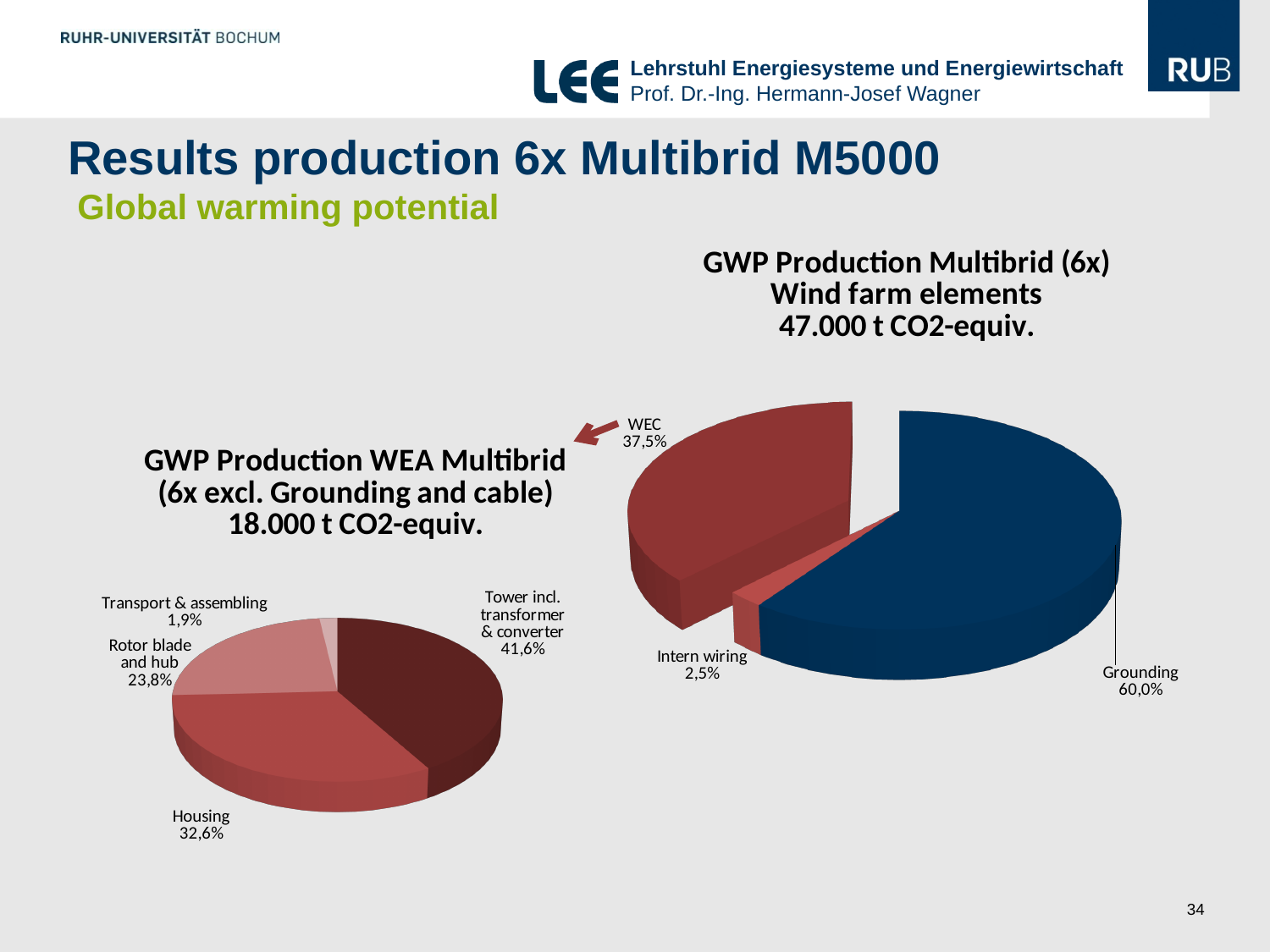
In the 'GWP Production Multibrid (6x) Wind farm elements' chart, what share does WEC have? 37,5% In the 'GWP Production Multibrid (6x) Wind farm elements' chart, how many slices are there? 3 In the 'GWP Production Multibrid (6x) Wind farm elements' chart, what share does Grounding have? 60,0% In the 'GWP Production WEA Multibrid (6x excl. Grounding and cable)' chart, what share does Rotor blade and hub have? 23,8% In the 'GWP Production WEA Multibrid (6x excl. Grounding and cable)' chart, what share does Housing have? 32,6% In the 'GWP Production WEA Multibrid (6x excl. Grounding and cable)' chart, which slice is the smallest? Transport & assembling In the 'GWP Production WEA Multibrid (6x excl. Grounding and cable)' chart, which slice is the largest? Tower incl. transformer & converter In the 'GWP Production WEA Multibrid (6x excl. Grounding and cable)' chart, how many slices are there? 4 In the 'GWP Production Multibrid (6x) Wind farm elements' chart, what is the difference between the Grounding and WEC shares? 22,5% What kind of chart is used for the 'GWP Production Multibrid (6x) Wind farm elements' data? Pie chart In the 'GWP Production Multibrid (6x) Wind farm elements' chart, which slice is the smallest? Intern wiring In the 'GWP Production WEA Multibrid (6x excl. Grounding and cable)' chart, which is larger: Housing or Rotor blade and hub? Housing